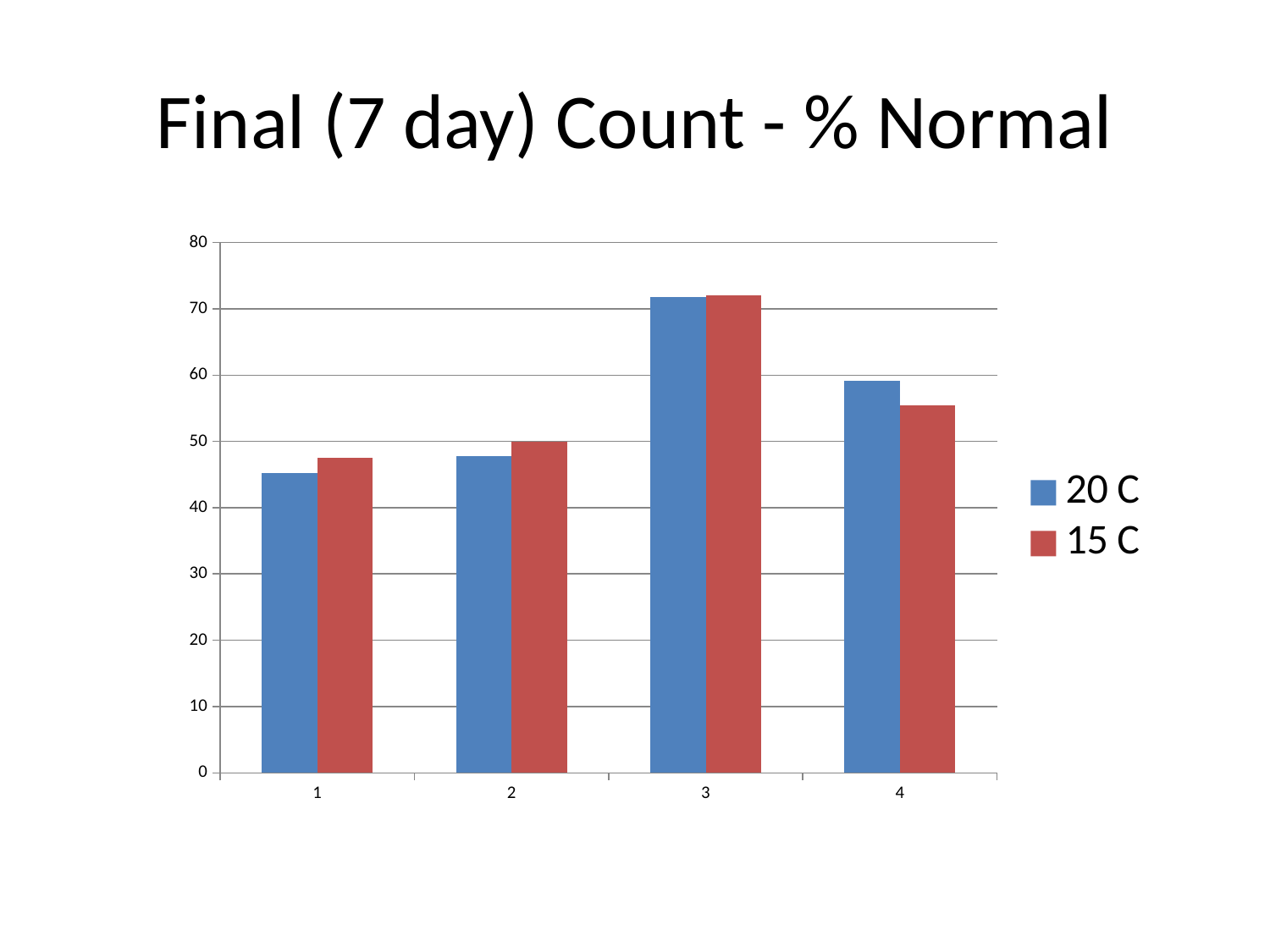
Which category has the lowest value for the 20 C series? 1 Is the value for 15 C in category 4 greater or less than 60? less Is the value for 20 C in category 3 greater or less than 70? greater Is the value for 20 C in category 1 greater or less than 50? less How many categories are shown on the x axis? 4 In category 4, which series has the larger value, 20 C or 15 C? 20 C What is the title of the chart? Final (7 day) Count - % Normal How many series does the legend list? 2 What kind of chart is shown on the slide? bar chart Which category has the highest value for the 20 C series? 3 What are the two series named in the legend? 20 C and 15 C Which category has the highest value for the 15 C series? 3